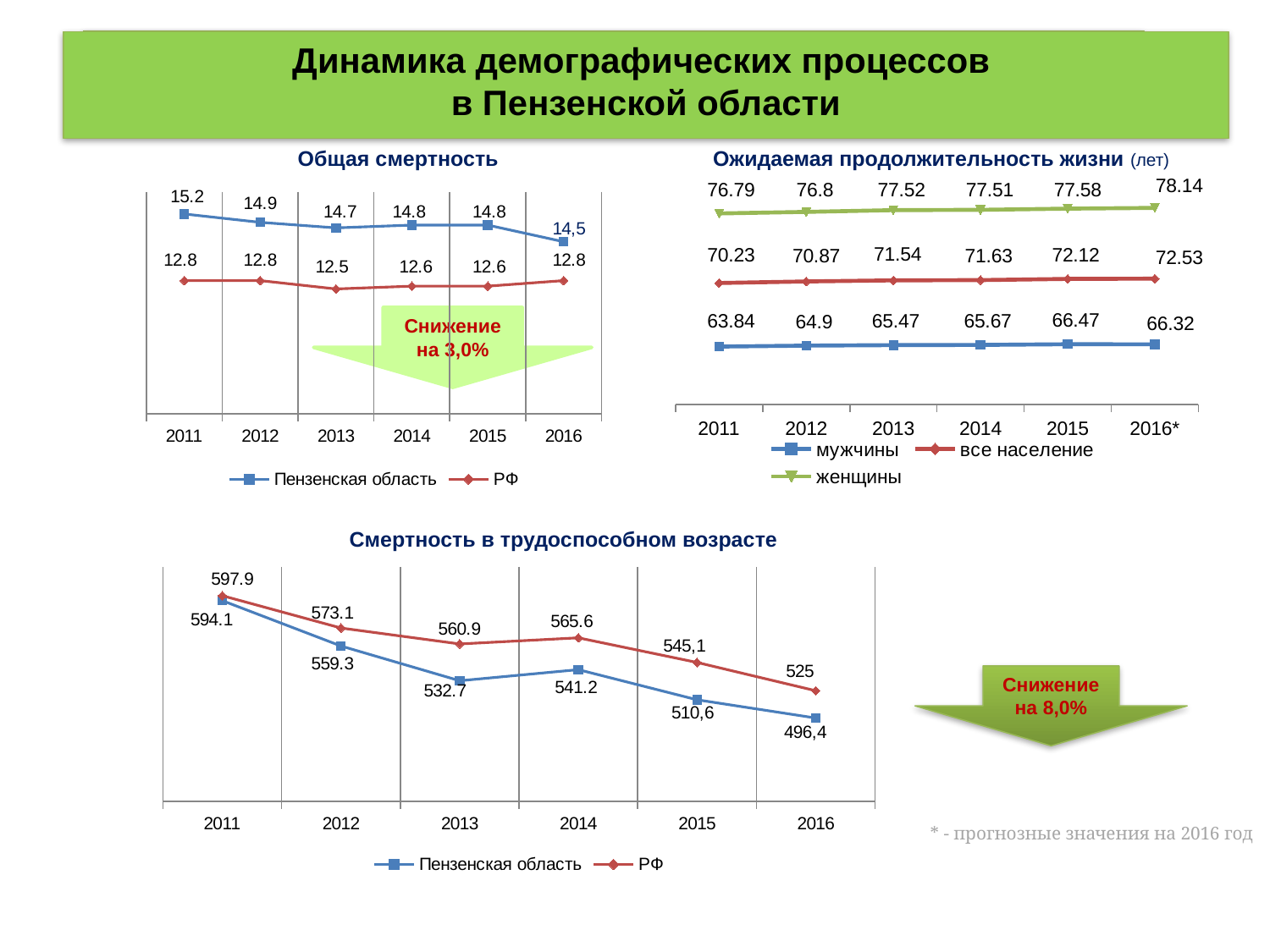
On the 'Ожидаемая продолжительность жизни' chart, what is the value for мужчины in 2013? 65.47 On the 'Общая смертность' chart, what is the value for Пензенская область in 2011? 15.2 On the 'Общая смертность' chart, what is the difference between Пензенская область and РФ in 2011? 2.4 On the 'Смертность в трудоспособном возрасте' chart, what is the value for РФ in 2014? 565.6 On the 'Смертность в трудоспособном возрасте' chart, which series has the larger value in 2016, Пензенская область or РФ? РФ On the 'Общая смертность' chart, how many series does the legend list? 2 What kind of chart is 'Смертность в трудоспособном возрасте'? line chart On the 'Ожидаемая продолжительность жизни' chart, in which year is the value for все население highest? 2016* On the 'Ожидаемая продолжительность жизни' chart, how many series does the legend list? 3 On the 'Ожидаемая продолжительность жизни' chart, what is the value for женщины in 2016*? 78.14 On the 'Общая смертность' chart, what is the value for РФ in 2013? 12.5 On the 'Общая смертность' chart, in which year is the Пензенская область value lowest? 2016